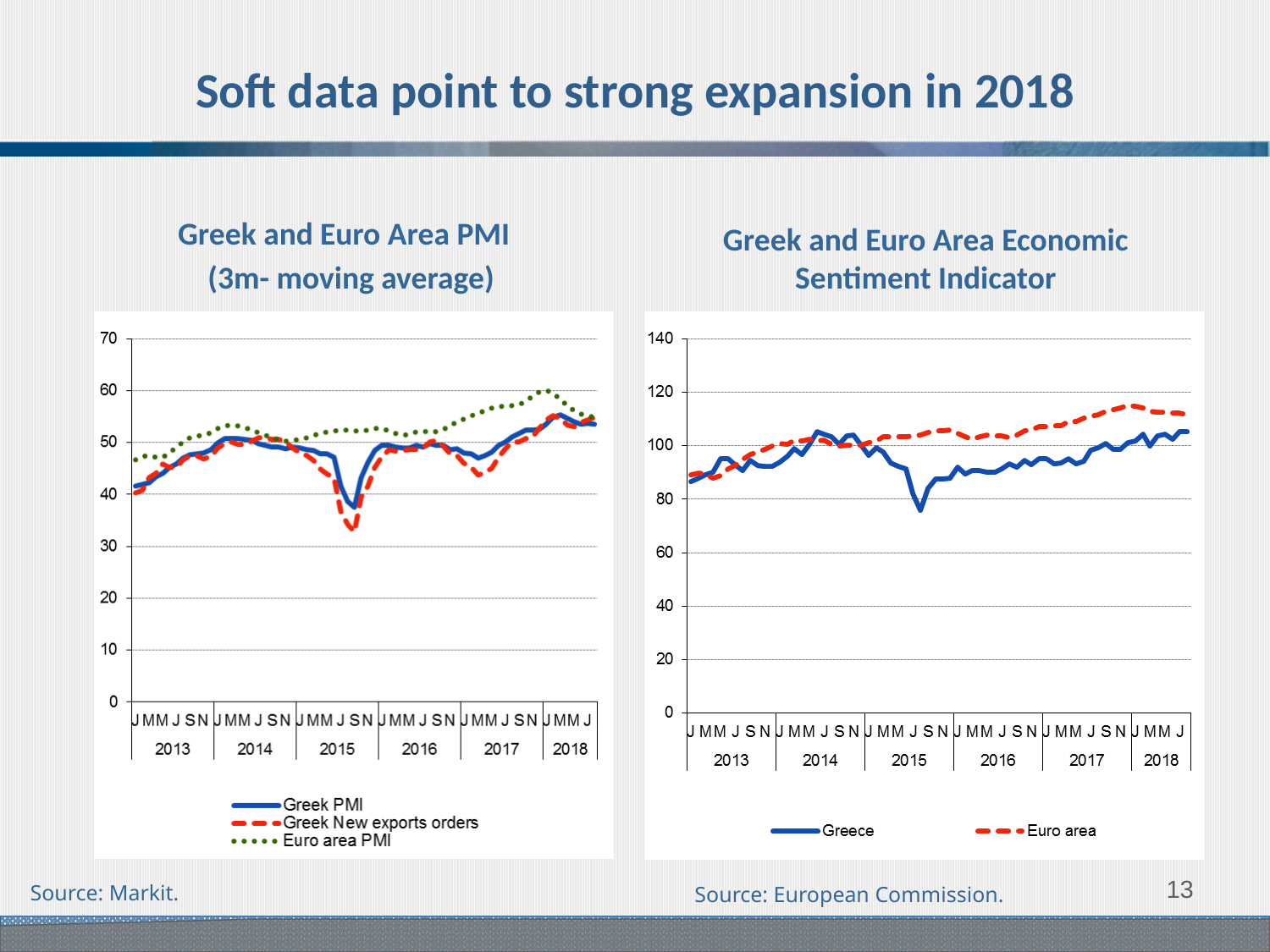
Which series in the 'Greek and Euro Area PMI (3m- moving average)' chart is drawn as a green dotted line? Euro area PMI In the 'Greek and Euro Area PMI (3m- moving average)' chart, is the lowest value of Greek New exports orders in 2015 greater or less than 40? less In the 'Greek and Euro Area Economic Sentiment Indicator' chart, which series is higher in 2018, Greece or Euro area? Euro area What kind of chart is the 'Greek and Euro Area Economic Sentiment Indicator' chart? line chart How many series does the legend of the 'Greek and Euro Area PMI (3m- moving average)' chart list? 3 How many series does the legend of the 'Greek and Euro Area Economic Sentiment Indicator' chart list? 2 In the 'Greek and Euro Area PMI (3m- moving average)' chart, is the Euro area PMI at the start of 2013 greater or less than 50? less In the 'Greek and Euro Area Economic Sentiment Indicator' chart, does the Greece series rise or fall from 2016 to 2018? rise In the 'Greek and Euro Area PMI (3m- moving average)' chart, which series dips lower in late 2015, Greek PMI or Greek New exports orders? Greek New exports orders In the 'Greek and Euro Area Economic Sentiment Indicator' chart, is the Euro area value in 2018 greater or less than 100? greater What kind of chart is the 'Greek and Euro Area PMI (3m- moving average)' chart? line chart